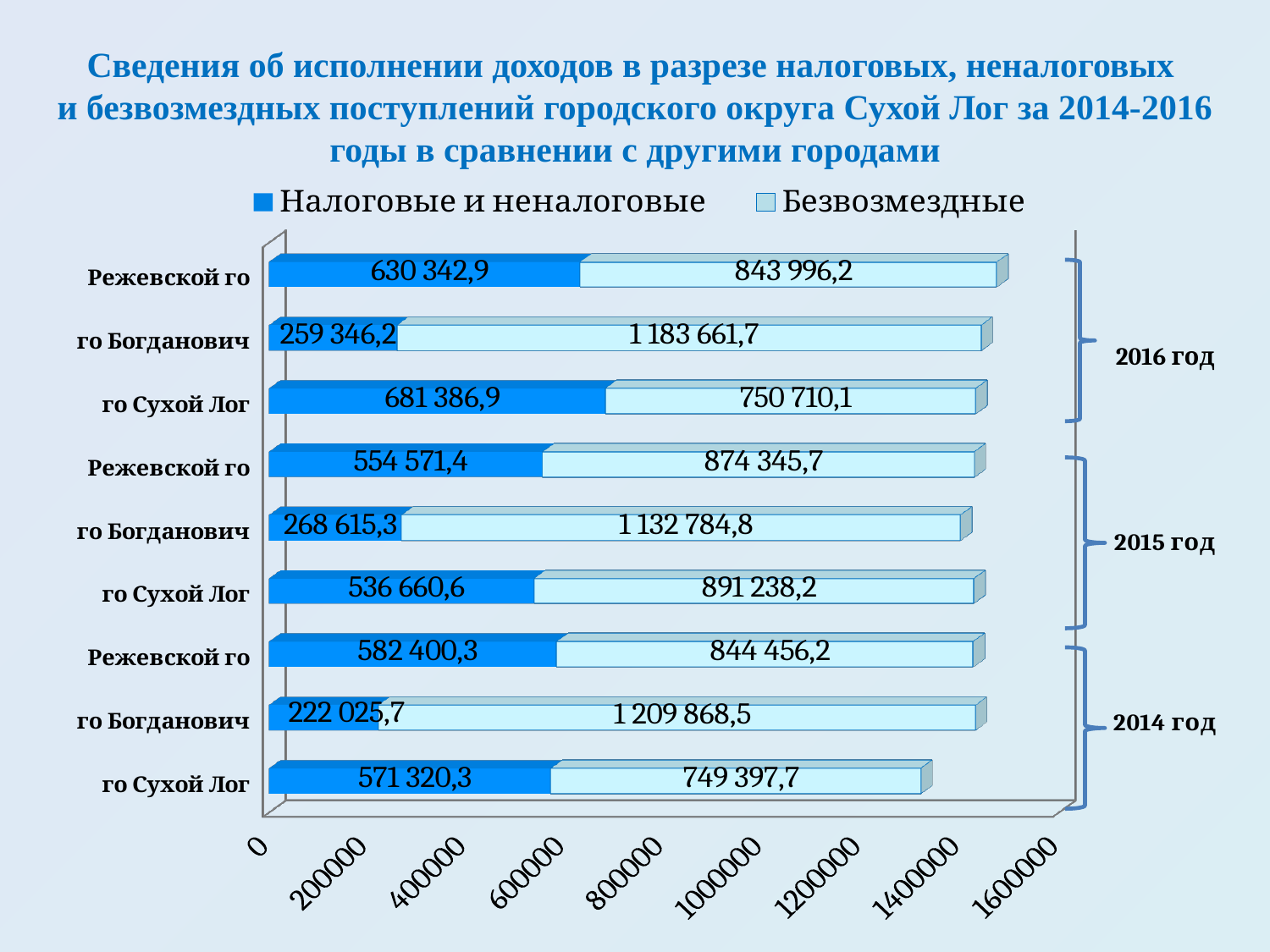
What is the value of Налоговые и неналоговые for го Сухой Лог in 2016 год? 681 386,9 What are the two series named in the legend? Налоговые и неналоговые; Безвозмездные How many series does the legend list? 2 What is the value of Безвозмездные for Режевской го in 2015 год? 874 345,7 What is the value of Безвозмездные for го Богданович in 2014 год? 1 209 868,5 What kind of chart is shown on the slide? Stacked bar chart How many bars are plotted on the chart? 9 Which bar has the lowest value for Налоговые и неналоговые? го Богданович, 2014 год What is the difference between Безвозмездные and Налоговые и неналоговые for Режевской го in 2016 год? 213 653,3 Which bar has the highest value for Налоговые и неналоговые? го Сухой Лог, 2016 год Which is larger in 2015 год: Безвозмездные for го Богданович or Безвозмездные for Режевской го? го Богданович What is the total of the stacked bar for го Сухой Лог in 2016 год? 1 432 097,0